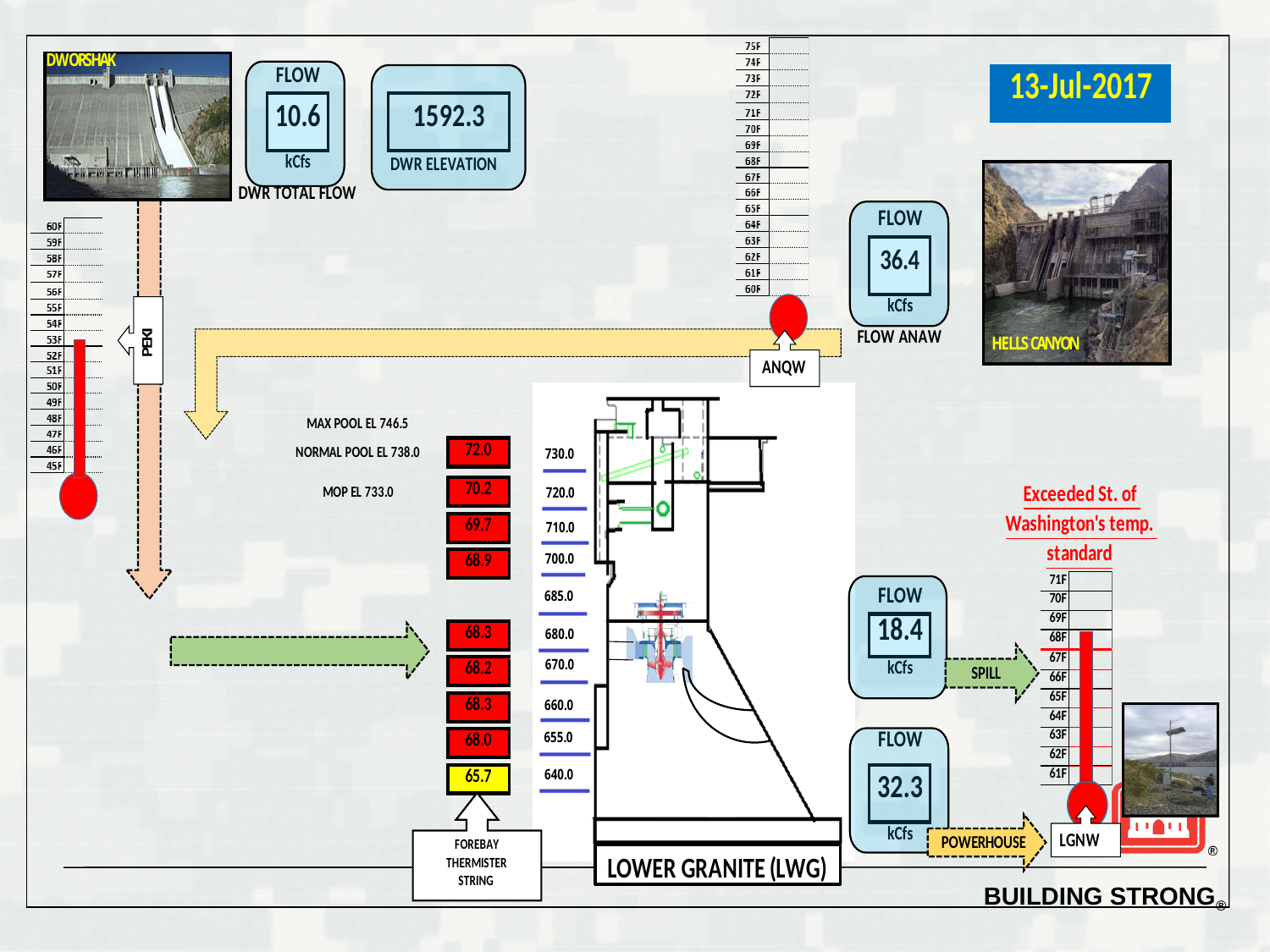
How many temperature readings are shown on the forebay thermistor string? 9 What is the SPILL flow shown for Lower Granite? 18.4 kCfs On the forebay thermistor string at Lower Granite, what temperature is shown at the 730.0 elevation? 72.0 Which is larger at Lower Granite, the SPILL flow or the POWERHOUSE flow? POWERHOUSE On the LGNW thermometer, is the temperature reading greater or less than 65F? greater On the forebay thermistor string, what is the highest temperature reading shown? 72.0 On the forebay thermistor string, what is the lowest temperature reading shown? 65.7 What is the DWR TOTAL FLOW value shown for Dworshak? 10.6 kCfs What is the FLOW ANAW value shown? 36.4 kCfs What is the DWR ELEVATION value shown? 1592.3 What is the POWERHOUSE flow shown for Lower Granite? 32.3 kCfs On the forebay thermistor string, what is the difference between the highest reading (72.0) and the lowest reading (65.7)? 6.3